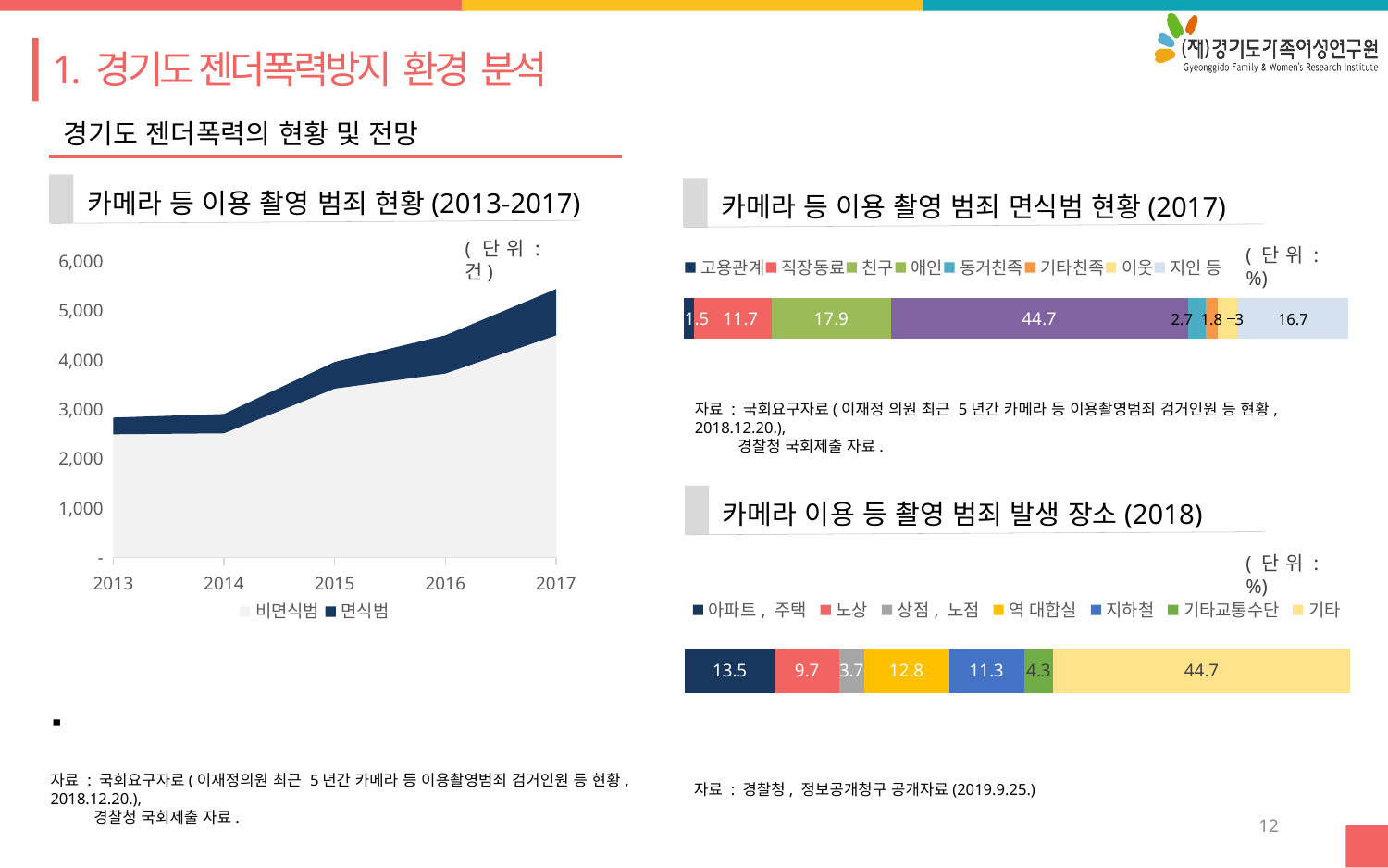
What kind of chart is the left chart titled 카메라 등 이용 촬영 범죄 현황 (2013-2017)? Stacked area chart In the left chart 카메라 등 이용 촬영 범죄 현황 (2013-2017), is the total for 2017 greater or less than 5,000? greater In the chart 카메라 이용 등 촬영 범죄 발생 장소 (2018), which category has the highest value? 기타 In the chart 카메라 등 이용 촬영 범죄 면식범 현황 (2017), how many categories does the legend list? 8 In the left chart 카메라 등 이용 촬영 범죄 현황 (2013-2017), how many series does the legend list? 2 In the chart 카메라 등 이용 촬영 범죄 면식범 현황 (2017), which category has the lowest value? 고용관계 In the chart 카메라 등 이용 촬영 범죄 면식범 현황 (2017), what is the value for 애인? 44.7 In the left chart 카메라 등 이용 촬영 범죄 현황 (2013-2017), how many years are shown on the x axis? 5 In the left chart 카메라 등 이용 촬영 범죄 현황 (2013-2017), does the total number of cases rise or fall from 2013 to 2017? Rise In the chart 카메라 이용 등 촬영 범죄 발생 장소 (2018), which is larger, 역 대합실 or 노상? 역 대합실 In the chart 카메라 이용 등 촬영 범죄 발생 장소 (2018), what is the value for 지하철? 11.3 In the chart 카메라 등 이용 촬영 범죄 면식범 현황 (2017), what is the difference between 친구 and 직장동료? 6.2